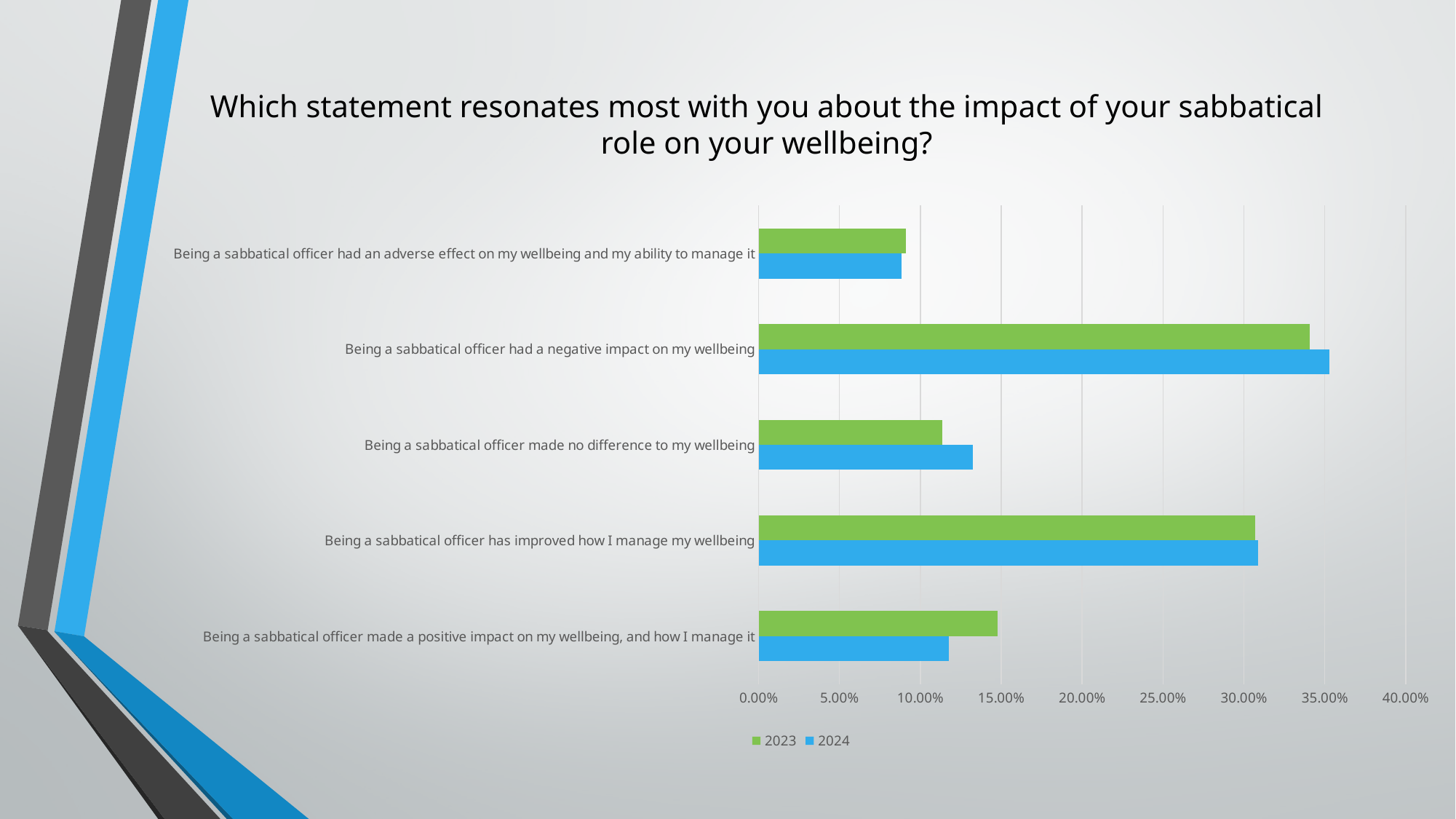
Is the 2023 value for 'Being a sabbatical officer had an adverse effect on my wellbeing and my ability to manage it' greater or less than 10.00%? less What kind of chart is shown on the slide? bar chart Is the 2024 value for 'Being a sabbatical officer made no difference to my wellbeing' greater or less than 15.00%? less Is the 2024 value for 'Being a sabbatical officer made a positive impact on my wellbeing, and how I manage it' greater or less than 10.00%? greater Which statement has the highest value for 2024? Being a sabbatical officer had a negative impact on my wellbeing Which statement has the highest value for 2023? Being a sabbatical officer had a negative impact on my wellbeing How many series does the legend list? 2 For 'Being a sabbatical officer made a positive impact on my wellbeing, and how I manage it', which year has the larger value, 2023 or 2024? 2023 Which colour represents the 2024 series in the chart? blue For 'Being a sabbatical officer made no difference to my wellbeing', which year has the larger value, 2023 or 2024? 2024 Which statement has the lowest value for 2024? Being a sabbatical officer had an adverse effect on my wellbeing and my ability to manage it How many statement categories are plotted on the chart? 5